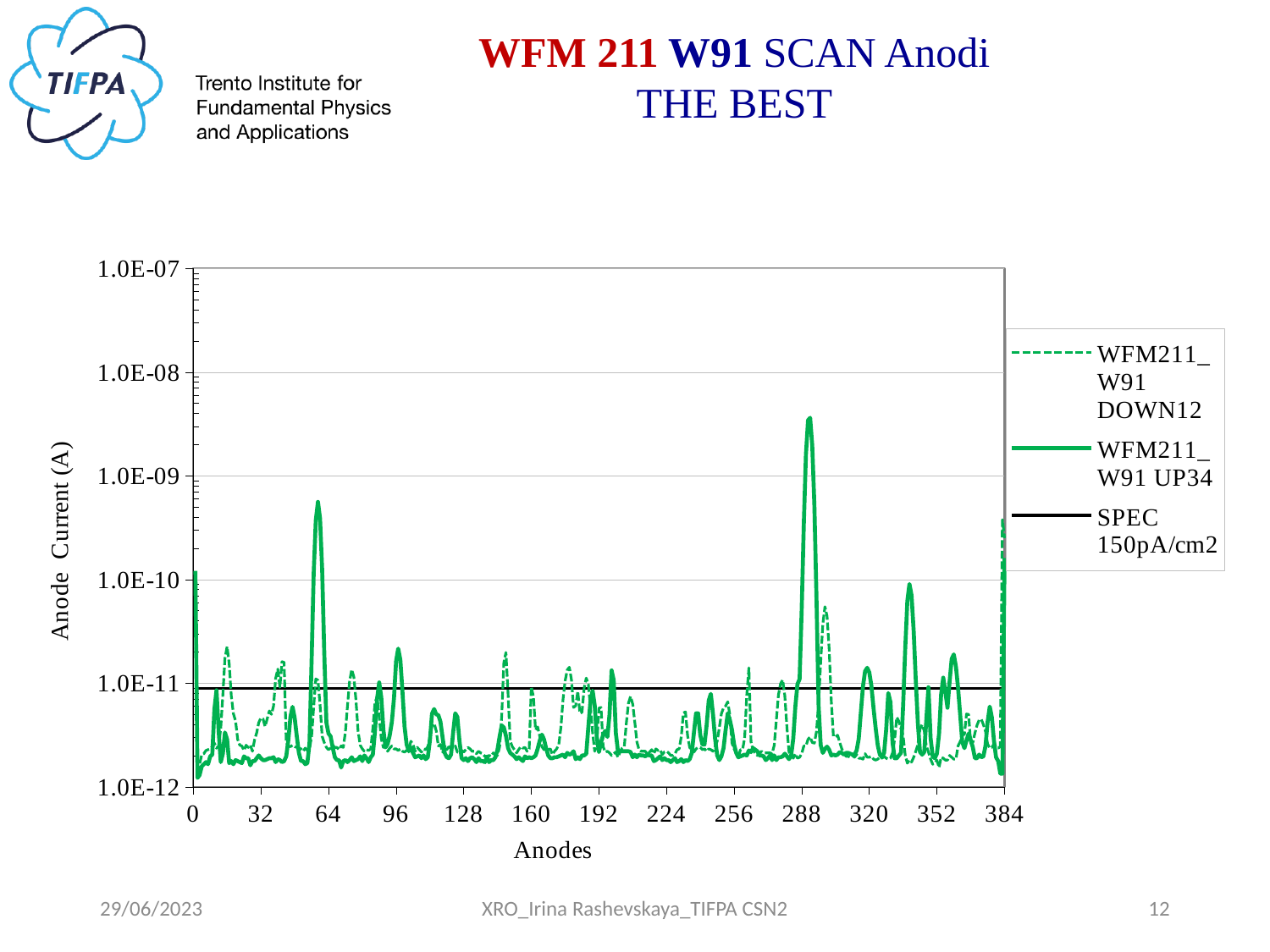
Is the peak of the WFM211_W91 UP34 series near anode 64 greater or less than 1.0E-09? less What is the title of the chart's x axis? Anodes What is the largest anode number shown on the x axis of the chart? 384 Is the peak of the WFM211_W91 UP34 series near anode 288 greater or less than 1.0E-09? greater What is the highest value shown on the y axis of the chart? 1.0E-07 Is the peak of the WFM211_W91 UP34 series near anode 288 greater or less than 1.0E-08? less What is the title of the chart's y axis? Anode Current (A) Near anode 288, which series has the higher anode current, WFM211_W91 UP34 or WFM211_W91 DOWN12? WFM211_W91 UP34 Which series reaches the highest anode current anywhere on the chart? WFM211_W91 UP34 How many series does the chart legend list? 3 What kind of chart is shown on the slide? line chart